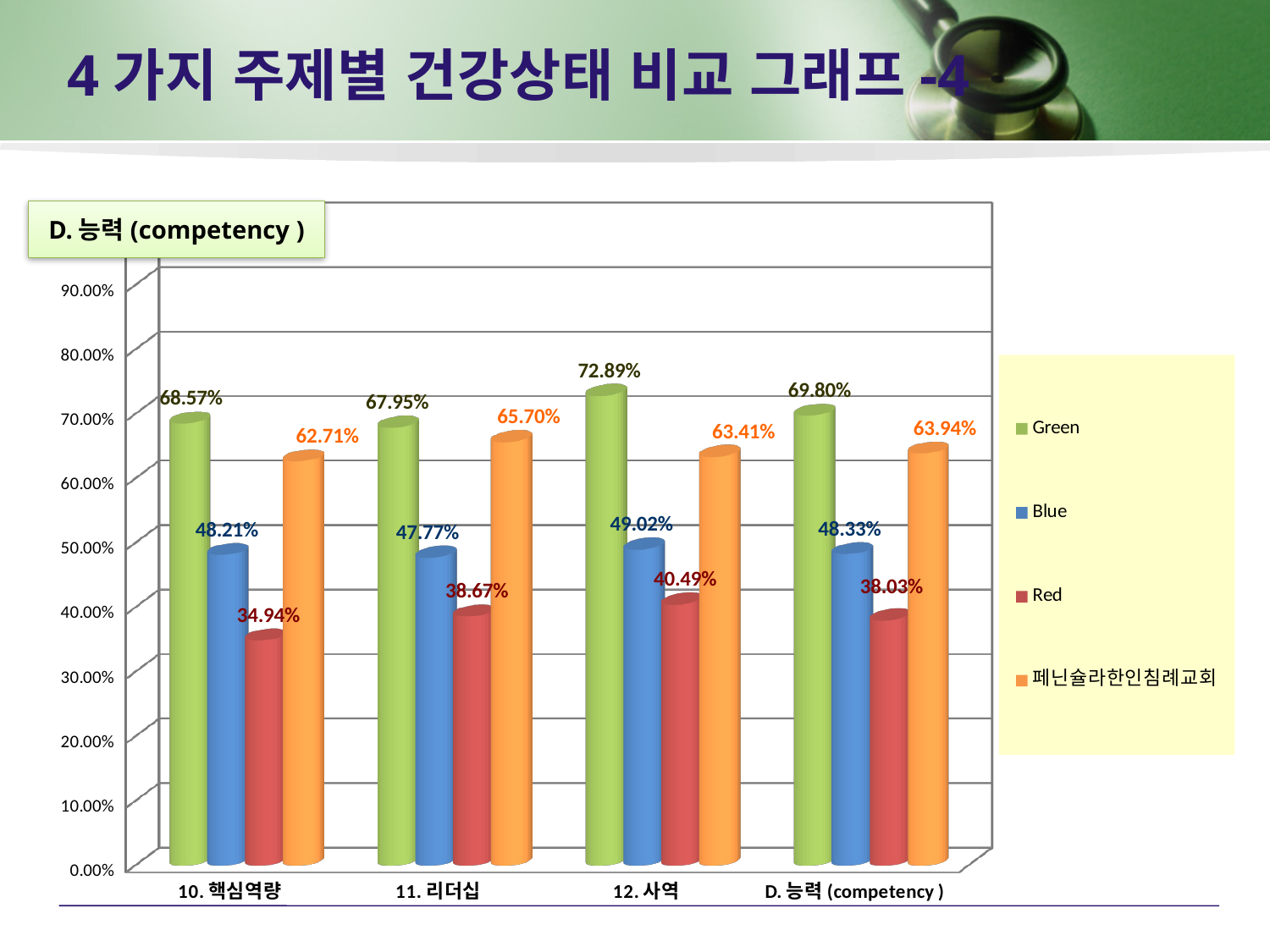
What is the label of the last series in the legend? 페닌슐라한인침례교회 What is the value of the Red series for 12. 사역? 40.49% What is the value of the Blue series for D. 능력 (competency )? 48.33% How many series does the legend list? 4 What kind of chart is shown on the slide? Bar chart Which category has the highest Green value? 12. 사역 How many categories are shown on the x axis? 4 Which category has the lowest Red value? 10. 핵심역량 What is the value of the 페닌슐라한인침례교회 series for 11. 리더십? 65.70% What is the difference between the Green and Red values for 10. 핵심역량? 33.63% For 11. 리더십, which is larger: the Green value or the 페닌슐라한인침례교회 value? Green What is the value of the Green series for 10. 핵심역량? 68.57%